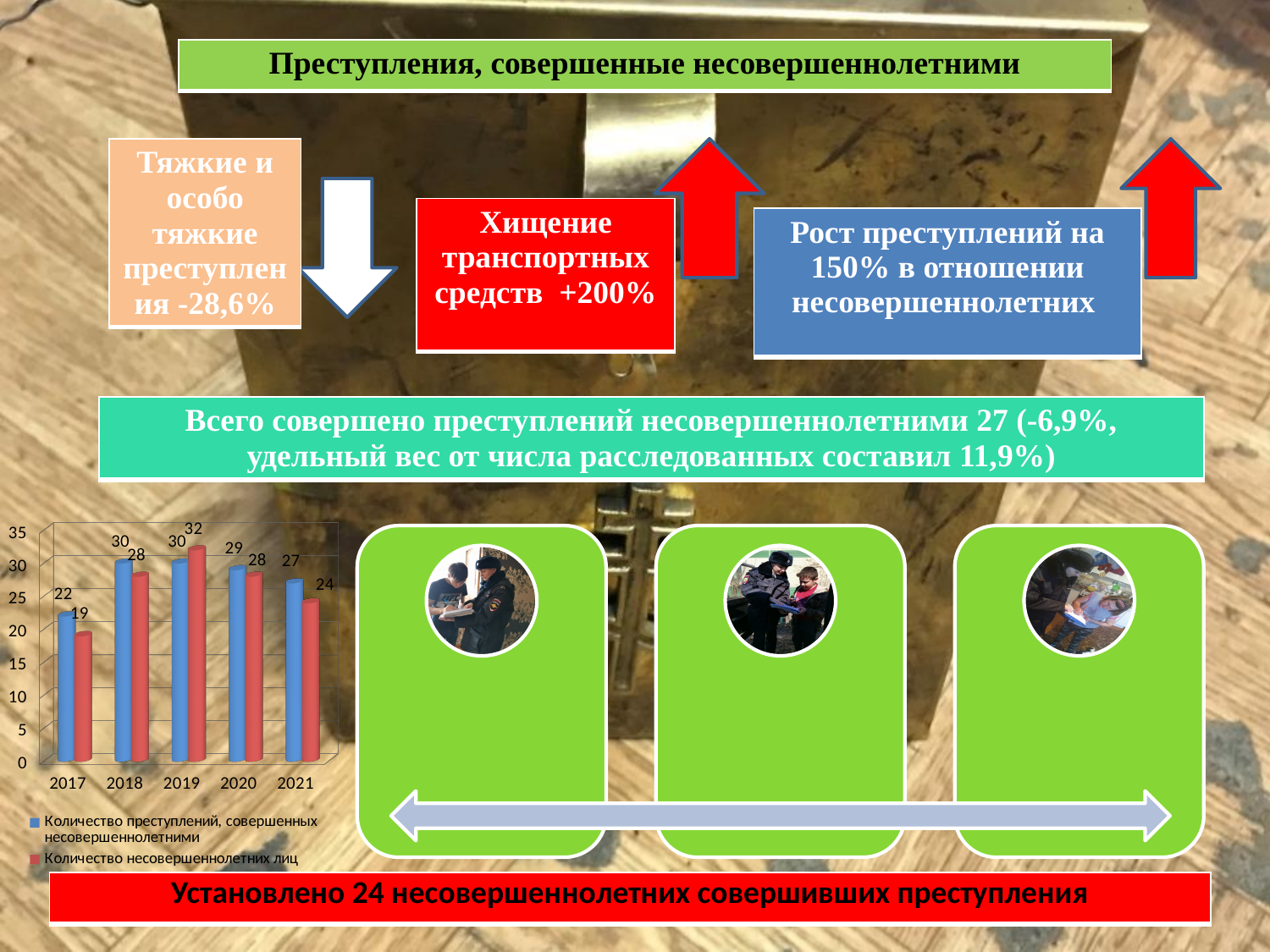
Does the series "Количество преступлений, совершенных несовершеннолетними" rise or fall from 2019 to 2021? fall What is the value for 2019 in the series "Количество несовершеннолетних лиц"? 32 Which year has the highest value in the series "Количество несовершеннолетних лиц"? 2019 In 2019, which series has the larger value: "Количество преступлений, совершенных несовершеннолетними" or "Количество несовершеннолетних лиц"? Количество несовершеннолетних лиц Is the value for 2017 in the series "Количество несовершеннолетних лиц" greater or less than 20? less What is the difference between the 2018 and 2017 values in the series "Количество преступлений, совершенных несовершеннолетними"? 8 How many years are shown on the x axis of the chart? 5 What is the value for 2017 in the series "Количество преступлений, совершенных несовершеннолетними"? 22 What is the value for 2021 in the series "Количество несовершеннолетних лиц"? 24 Which year has the lowest value in the series "Количество преступлений, совершенных несовершеннолетними"? 2017 How many series does the chart legend list? 2 What kind of chart is shown on the slide? bar chart